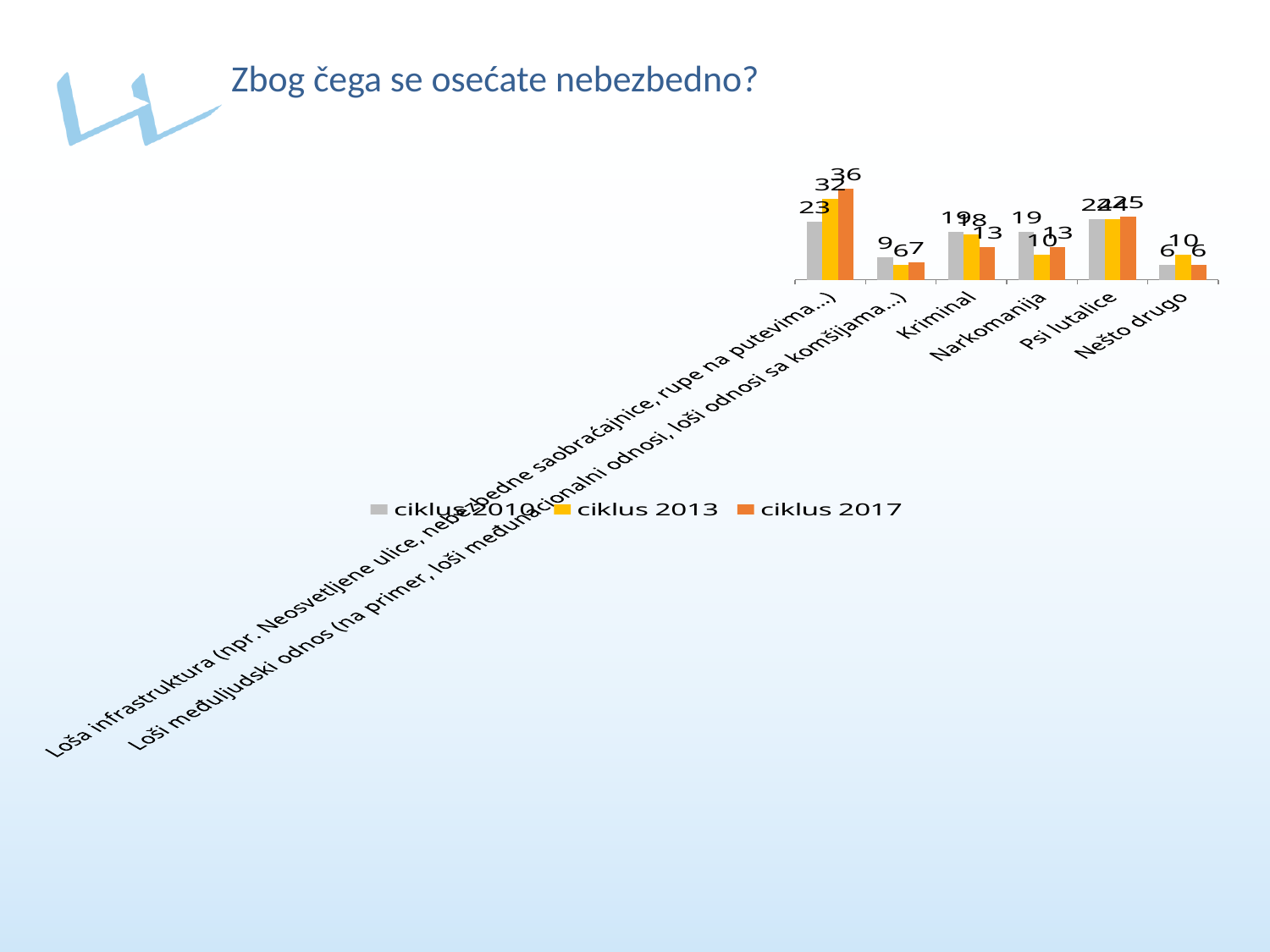
What is the value for Nešto drugo in ciklus 2013? 10 What is the difference between the ciklus 2017 and ciklus 2010 values for Loša infrastruktura? 13 What are the three legend entries of the chart? ciklus 2010, ciklus 2013, ciklus 2017 Which category has the lowest value in ciklus 2017? Nešto drugo What kind of chart is shown on the slide? bar chart What is the value for Narkomanija in ciklus 2013? 10 How many categories are shown on the x axis? 6 Which category has the highest value in ciklus 2017? Loša infrastruktura How many series does the legend list? 3 What is the value for Loša infrastruktura in ciklus 2017? 36 For Narkomanija, which is larger: the ciklus 2010 value or the ciklus 2013 value? ciklus 2010 What is the value for Loša infrastruktura in ciklus 2010? 23